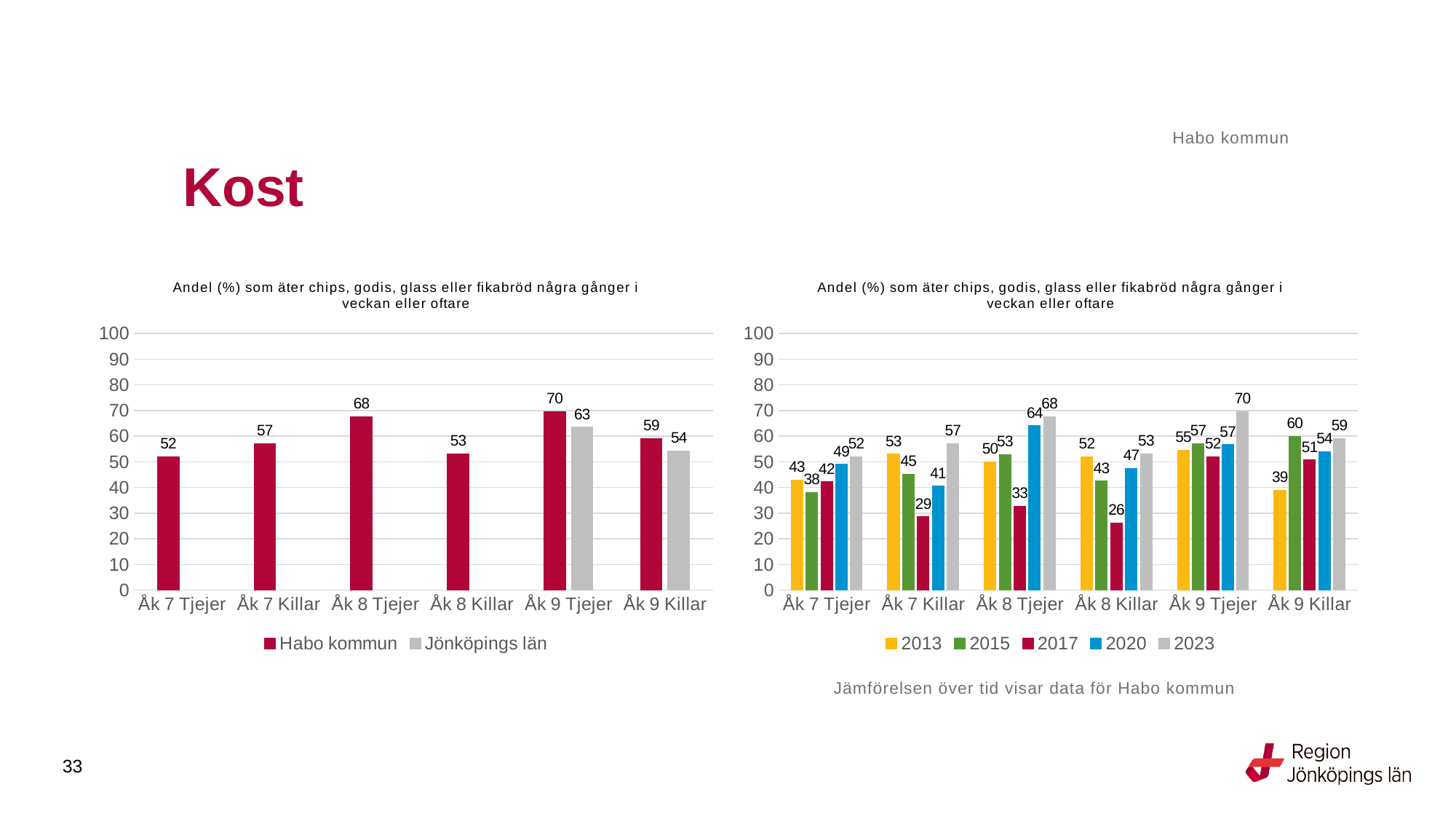
In the right chart, what is the 2017 value for Åk 8 Killar? 26 In the left chart, what is the difference between the Habo kommun and Jönköpings län values for Åk 9 Killar? 5 In the right chart, which year has the lowest value for Åk 7 Killar? 2017 In the right chart, is the 2015 value for Åk 9 Killar larger or the 2023 value for Åk 9 Killar? 2015 In the left chart, how many series does the legend list? 2 In the left chart, what is the Jönköpings län value for Åk 9 Tjejer? 63 In the left chart, which category has the lowest Habo kommun value? Åk 7 Tjejer In the right chart, what is the 2020 value for Åk 8 Tjejer? 64 In the left chart, which category has the highest Habo kommun value? Åk 9 Tjejer What kind of chart is the right chart? Bar chart In the right chart, how many series does the legend list? 5 In the left chart, what is the Habo kommun value for Åk 8 Tjejer? 68